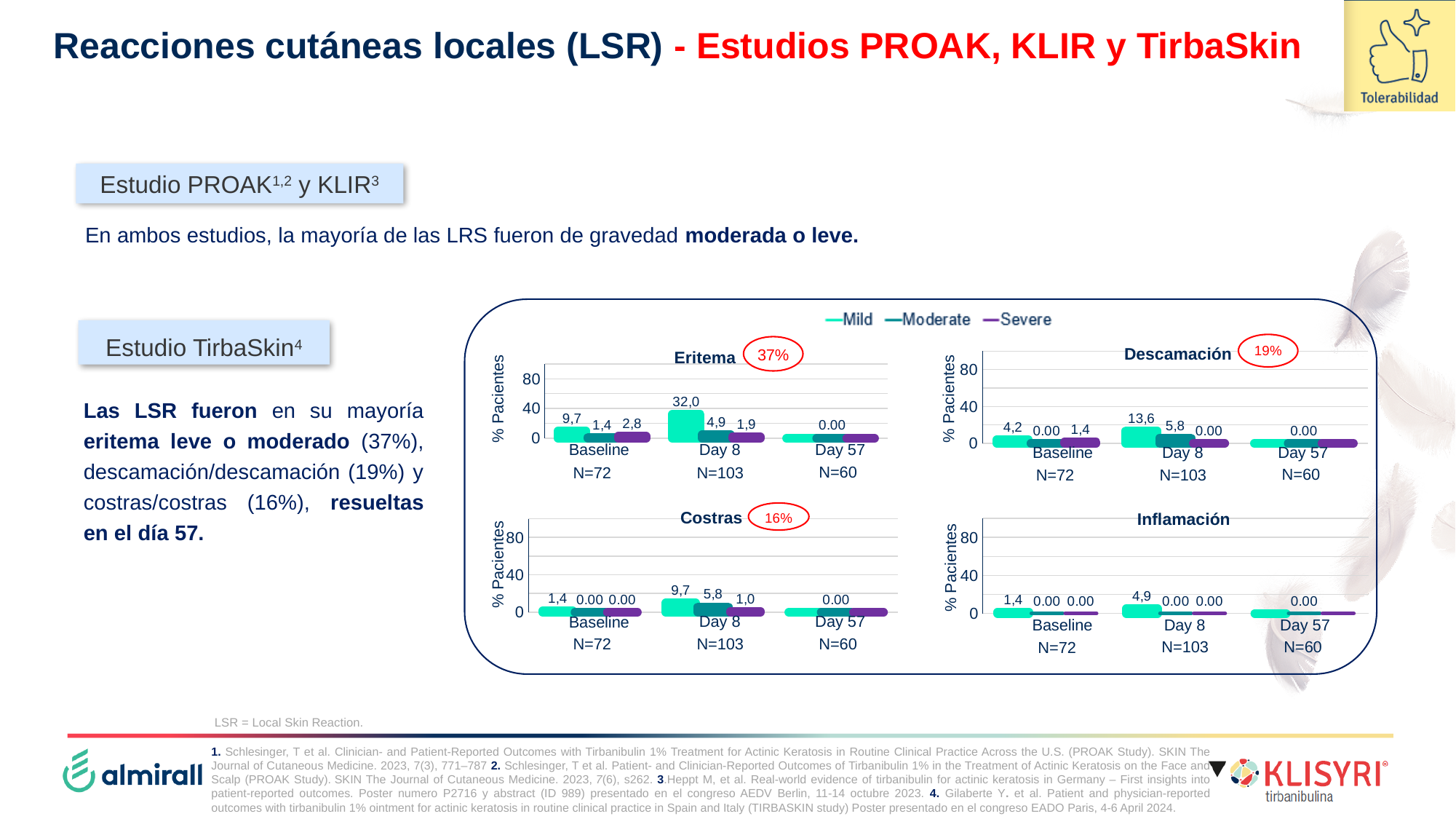
In the Inflamación chart, what is the value for Mild at Day 8? 4,9 In the Eritema chart, what is the value for Severe at Baseline? 2,8 In the Eritema chart, at which time point is the Mild value highest? Day 8 In the Descamación chart, which is larger at Day 8: Mild or Moderate? Mild In the Eritema chart, what is the difference between the Mild values at Day 8 and Baseline? 22,3 In the Eritema chart, is the Mild value at Day 8 greater or less than 40? less How many time points are shown on the x axis of the Costras chart? 3 In the Eritema chart, what is the value for Mild at Day 8? 32,0 What kind of chart is the Inflamación chart? Bar chart In the Costras chart, what is the value for Moderate at Day 8? 5,8 How many series does the legend list? 3 In the Descamación chart, what is the value for Mild at Day 8? 13,6